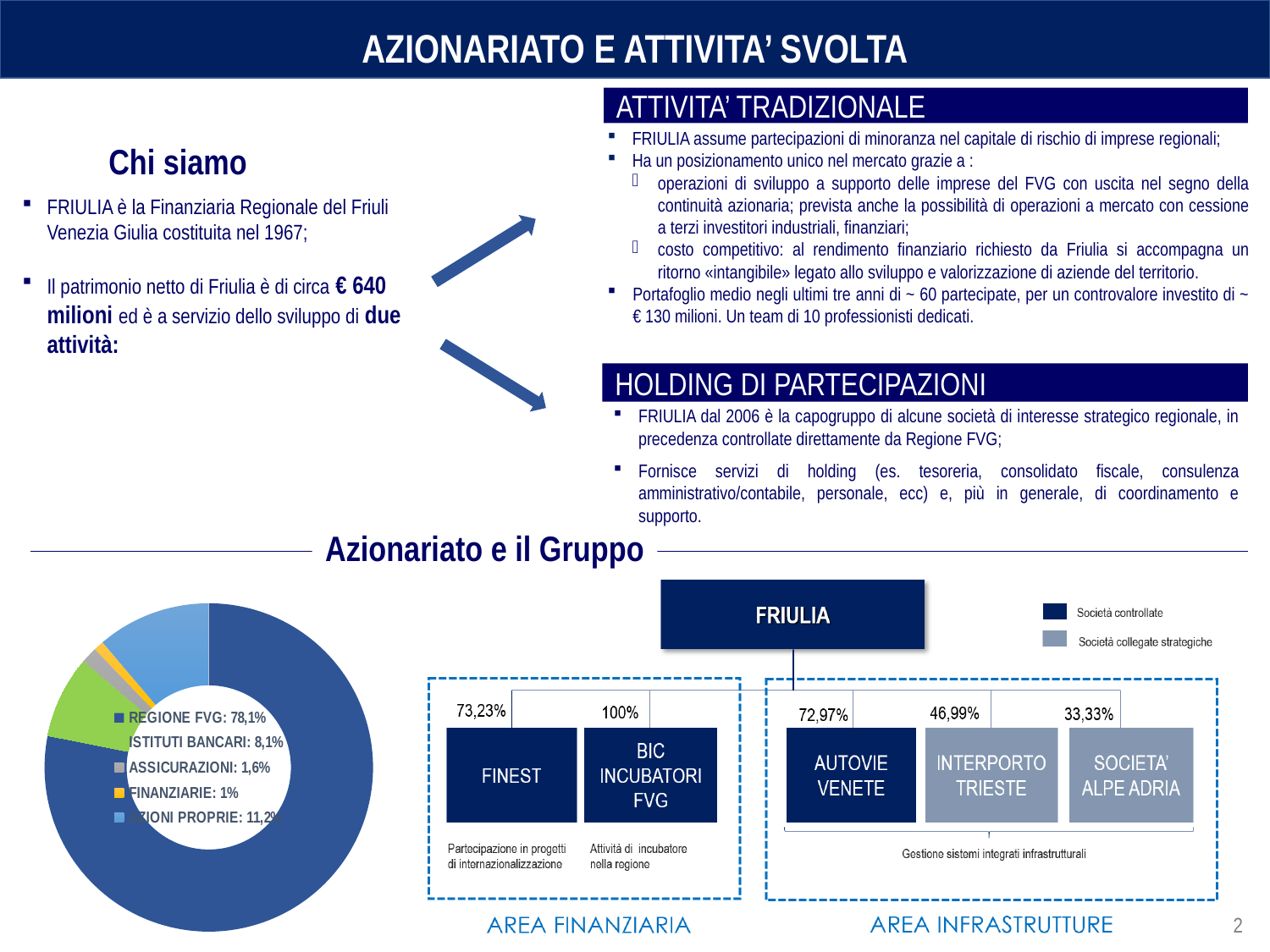
Which category has the smallest share in the doughnut chart? FINANZIARIE What is the value for ISTITUTI BANCARI in the doughnut chart? 8,1% What is the value for AZIONI PROPRIE in the doughnut chart? 11,2% Which is larger in the doughnut chart, ISTITUTI BANCARI or AZIONI PROPRIE? AZIONI PROPRIE How many categories does the doughnut chart show? 5 What is the difference between the REGIONE FVG and AZIONI PROPRIE shares in the doughnut chart? 66,9% What colour represents FINANZIARIE in the doughnut chart? orange What is the value for ASSICURAZIONI in the doughnut chart? 1,6% What type of chart is shown at the bottom left of the slide? doughnut chart What is the difference between the ISTITUTI BANCARI and ASSICURAZIONI shares in the doughnut chart? 6,5% Which category has the largest share in the doughnut chart? REGIONE FVG What is the value for REGIONE FVG in the doughnut chart? 78,1%